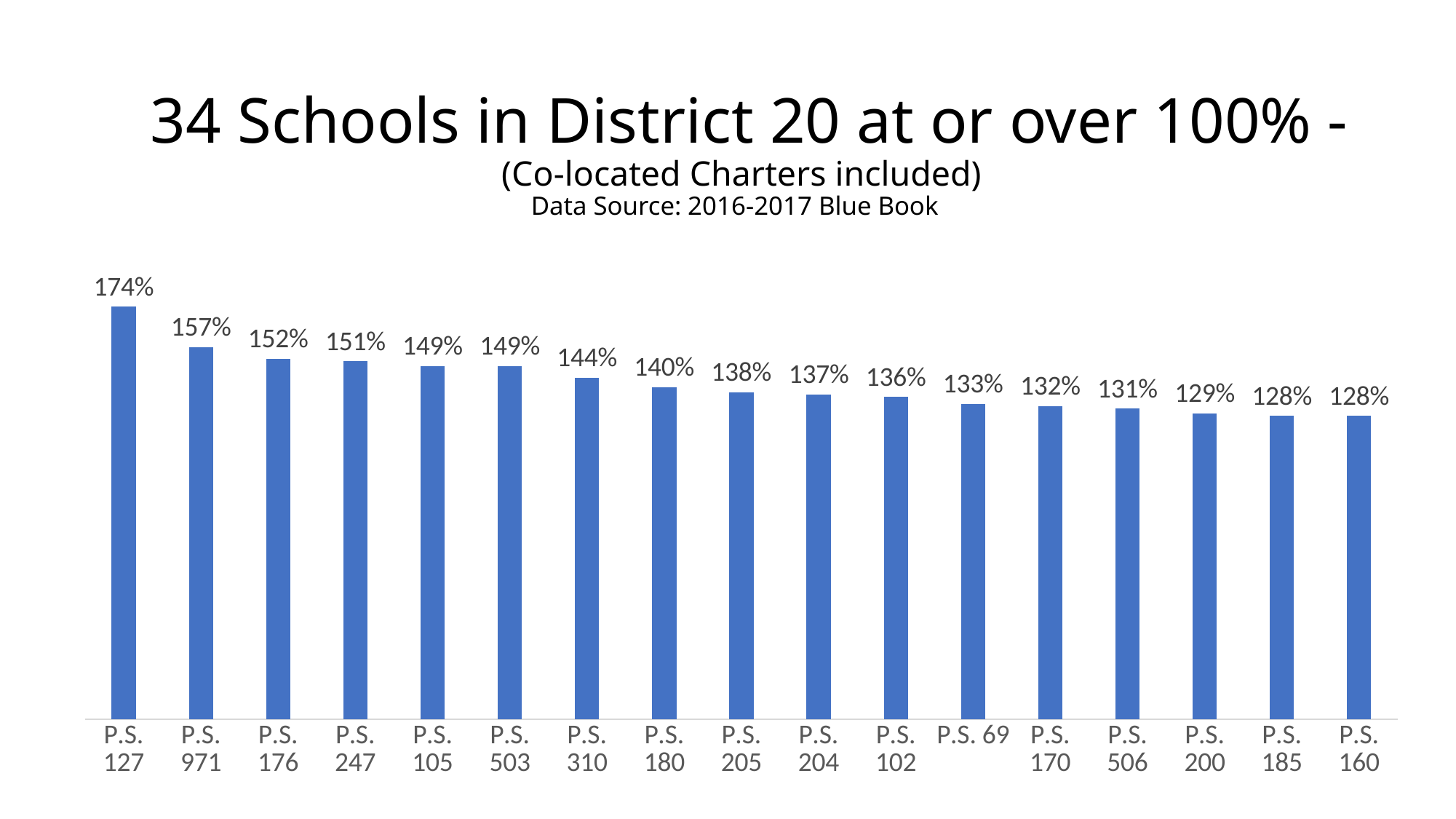
What is the difference between the values for P.S. 180 and P.S. 160? 12% What is the value for P.S. 69? 133% Which has a larger value, P.S. 200 or P.S. 102? P.S. 102 Do the values rise or fall from left to right along the x axis? Fall What is the value for P.S. 310? 144% What kind of chart is shown on the slide? Bar chart How many schools are shown as bars in the chart? 17 Which has a larger value, P.S. 176 or P.S. 205? P.S. 176 What is the difference between the values for P.S. 127 and P.S. 971? 17% What is the value for P.S. 127? 174% Which school has the highest value? P.S. 127 What is the value for P.S. 506? 131%